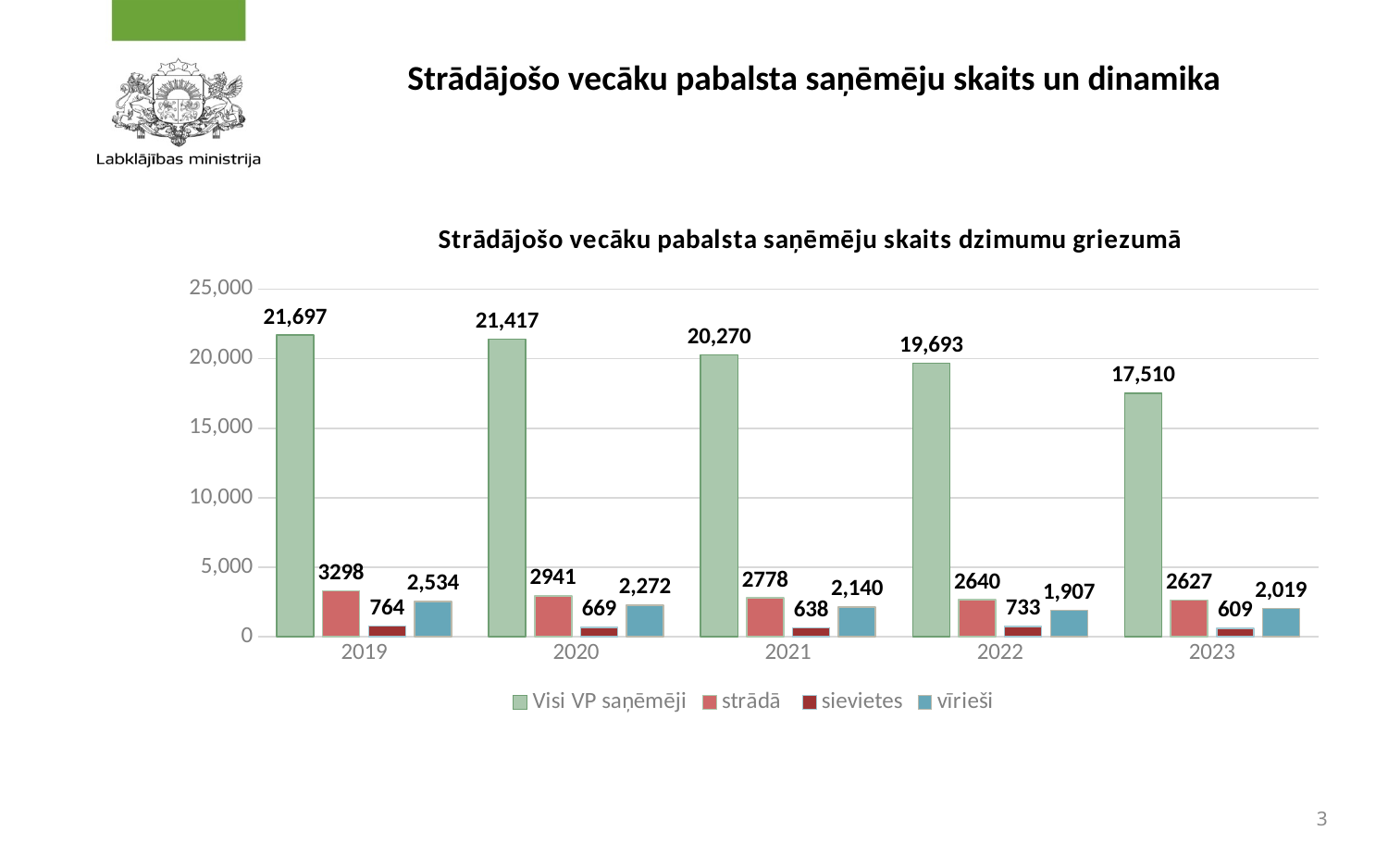
What is the value for strādā in 2021? 2778 In which year is the value for strādā highest? 2019 Is the value for Visi VP saņēmēji in 2022 greater or less than 20,000? less What is the value for sievietes in 2022? 733 What is the value for vīrieši in 2023? 2,019 Does the value for Visi VP saņēmēji rise or fall from 2019 to 2023? fall How many years are shown on the x axis? 5 Which is larger, the vīrieši value for 2022 or for 2023? 2023 In which year is the value for Visi VP saņēmēji lowest? 2023 What is the value for Visi VP saņēmēji in 2019? 21,697 What is the difference between the Visi VP saņēmēji values for 2019 and 2023? 4,187 How many series does the legend list? 4